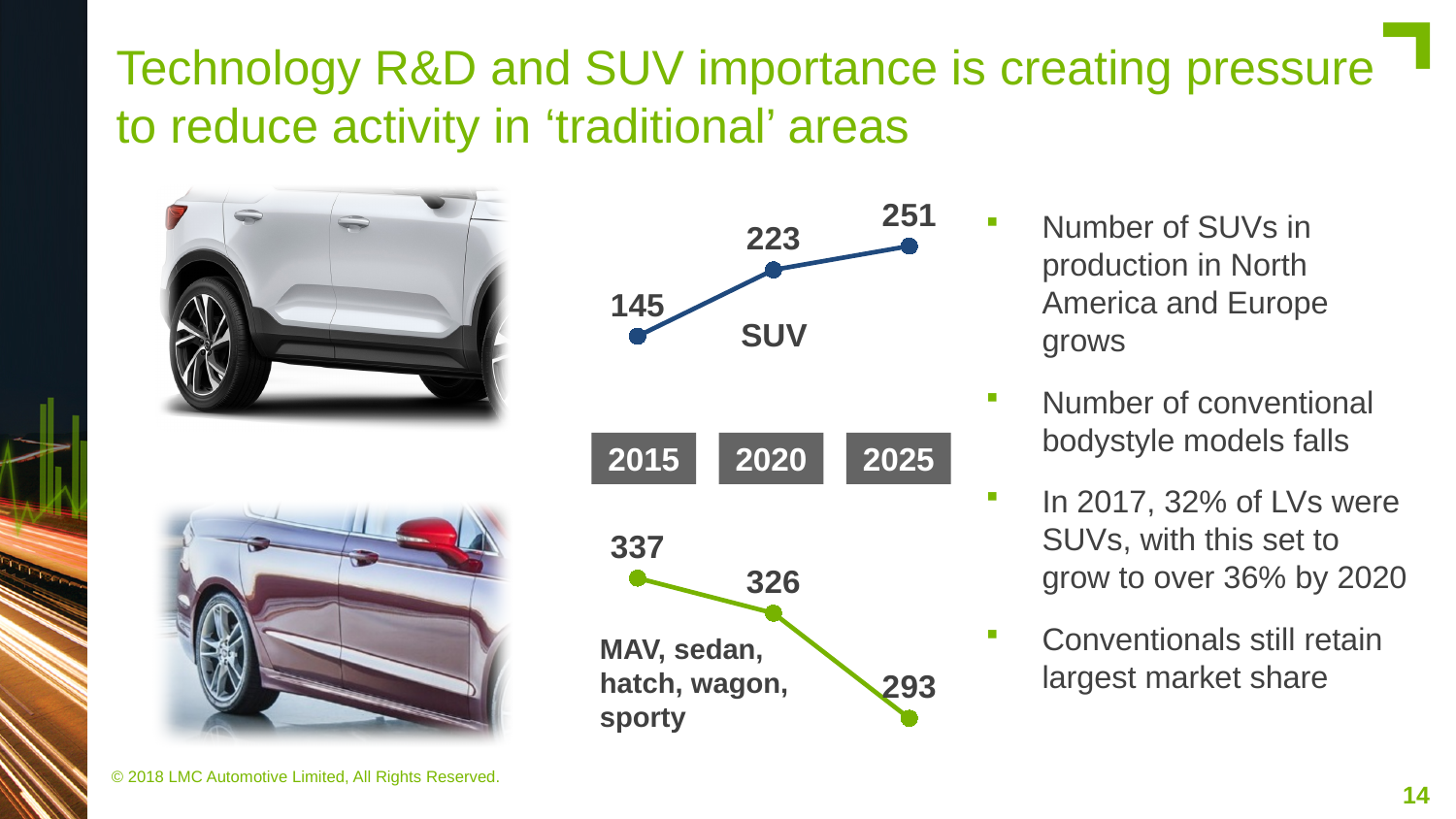
In the SUV chart, which year has the highest value? 2025 In the SUV chart, what is the value for 2025? 251 In the lower chart (MAV, sedan, hatch, wagon, sporty), do the values rise or fall from 2015 to 2025? Fall In the lower chart (MAV, sedan, hatch, wagon, sporty), what is the value for 2020? 326 In the lower chart (MAV, sedan, hatch, wagon, sporty), what is the difference between the 2015 and 2025 values? 44 In the SUV chart, what is the difference between the 2020 and 2015 values? 78 How many years are plotted in the SUV chart? 3 In the lower chart (MAV, sedan, hatch, wagon, sporty), which year has the lowest value? 2025 In the lower chart (MAV, sedan, hatch, wagon, sporty), what is the value for 2025? 293 What kind of chart is the SUV chart? Line chart In the SUV chart, what is the value for 2015? 145 Which is larger in 2025: the SUV value or the MAV, sedan, hatch, wagon, sporty value? MAV, sedan, hatch, wagon, sporty